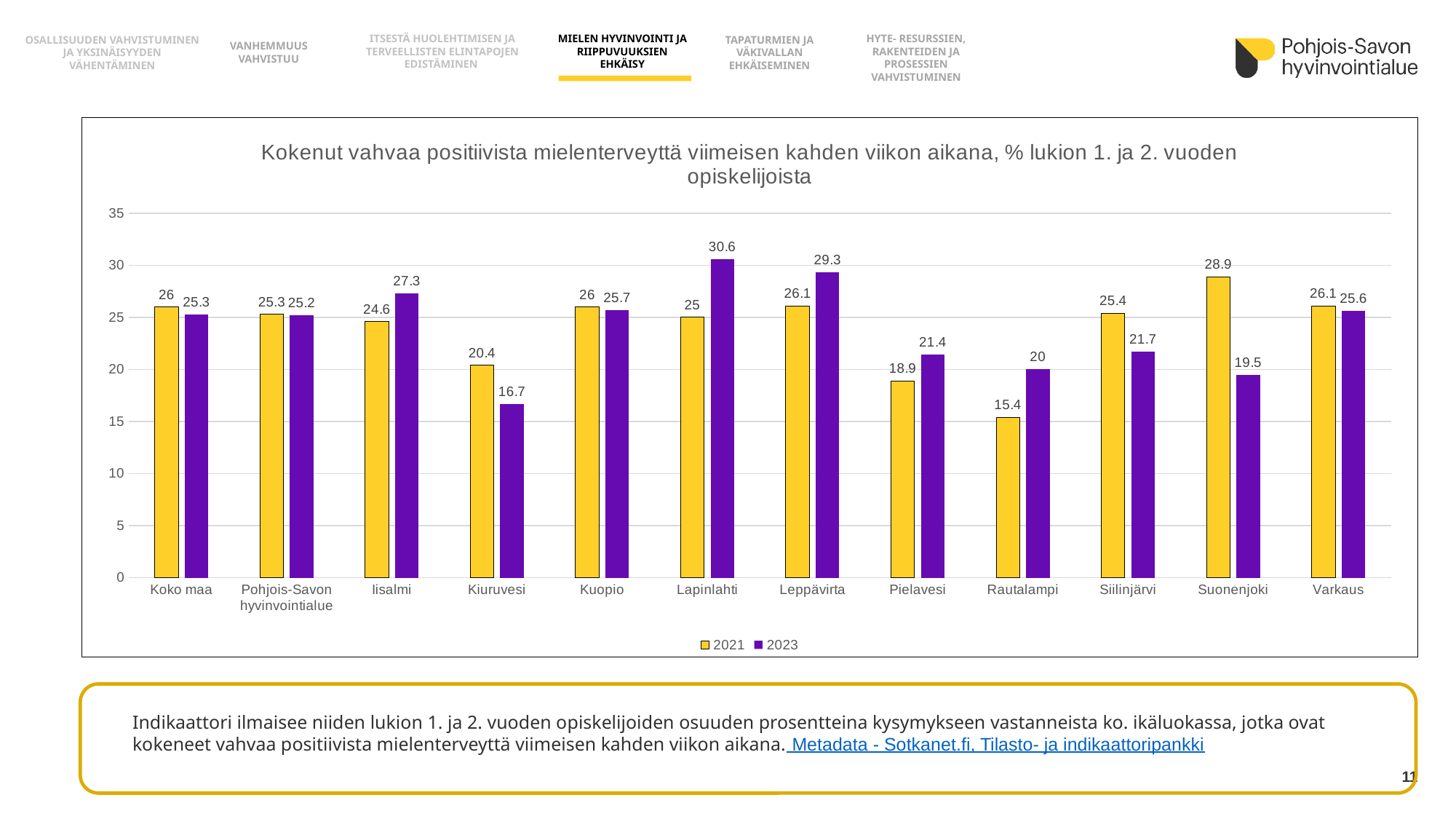
How many series does the legend list? 2 Which category has the lowest 2021 value? Rautalampi What is the 2023 value for Lapinlahti? 30.6 What is the difference between the 2021 and 2023 values for Suonenjoki? 9.4 What kind of chart is shown on the slide? Bar chart Which category has the highest 2021 value? Suonenjoki How many categories are shown on the x axis? 12 What is the 2023 value for Rautalampi? 20 Which is larger for Iisalmi, the 2021 value or the 2023 value? 2023 What is the 2021 value for Kiuruvesi? 20.4 Which colour represents the 2023 series in the legend? Purple Which category has the highest 2023 value? Lapinlahti